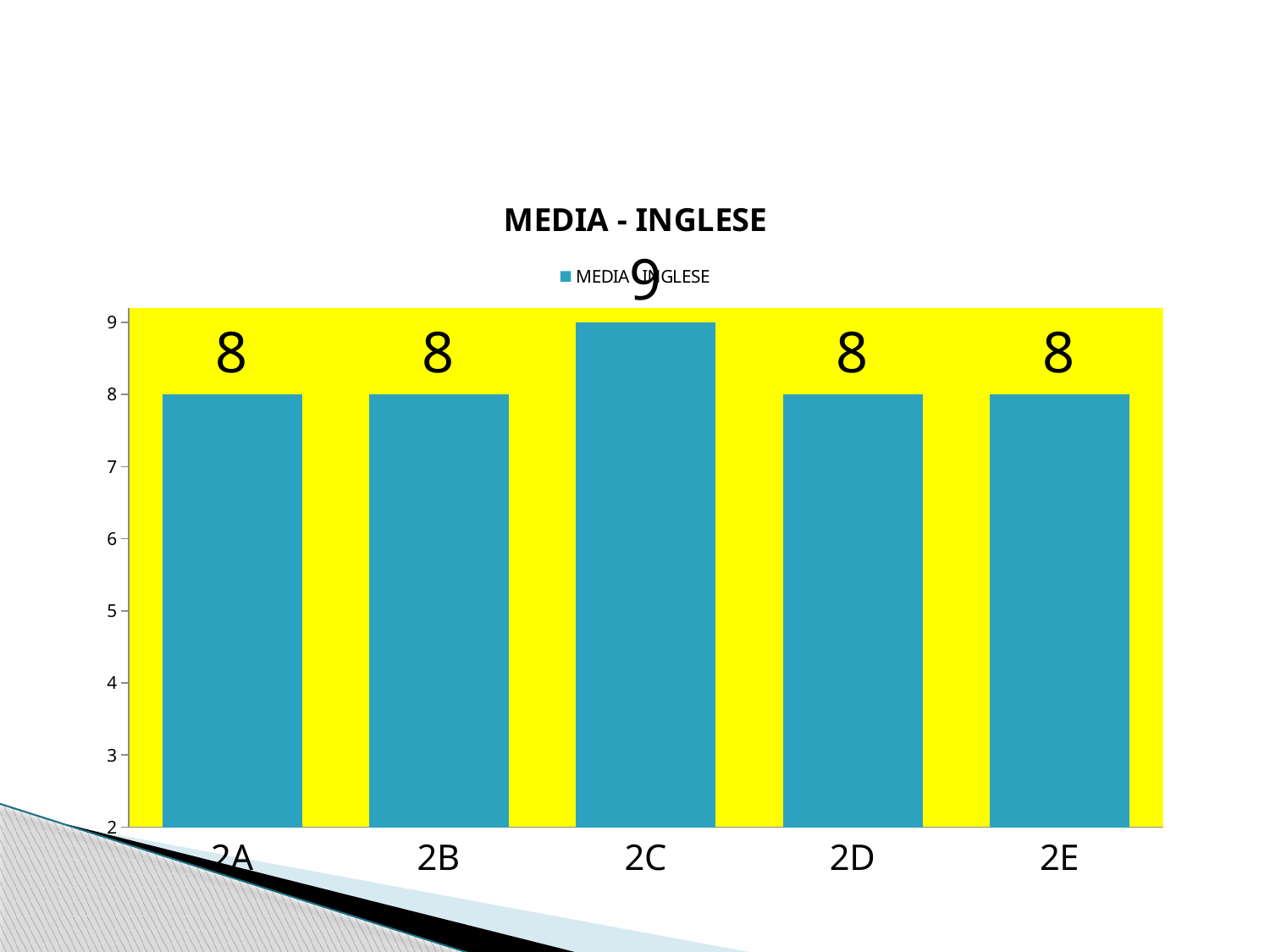
How many series does the legend list? 1 What is the title of the chart? MEDIA - INGLESE What is the value for 2C? 9 How many categories are shown on the x axis? 5 What is the value for 2A? 8 What is the value for 2E? 8 Which category has the highest value? 2C What is the difference between the values for 2C and 2D? 1 Is the value for 2D greater or less than 5? greater What kind of chart is shown? bar chart What is the background colour of the plot area? yellow Which is larger, the value for 2C or the value for 2B? 2C